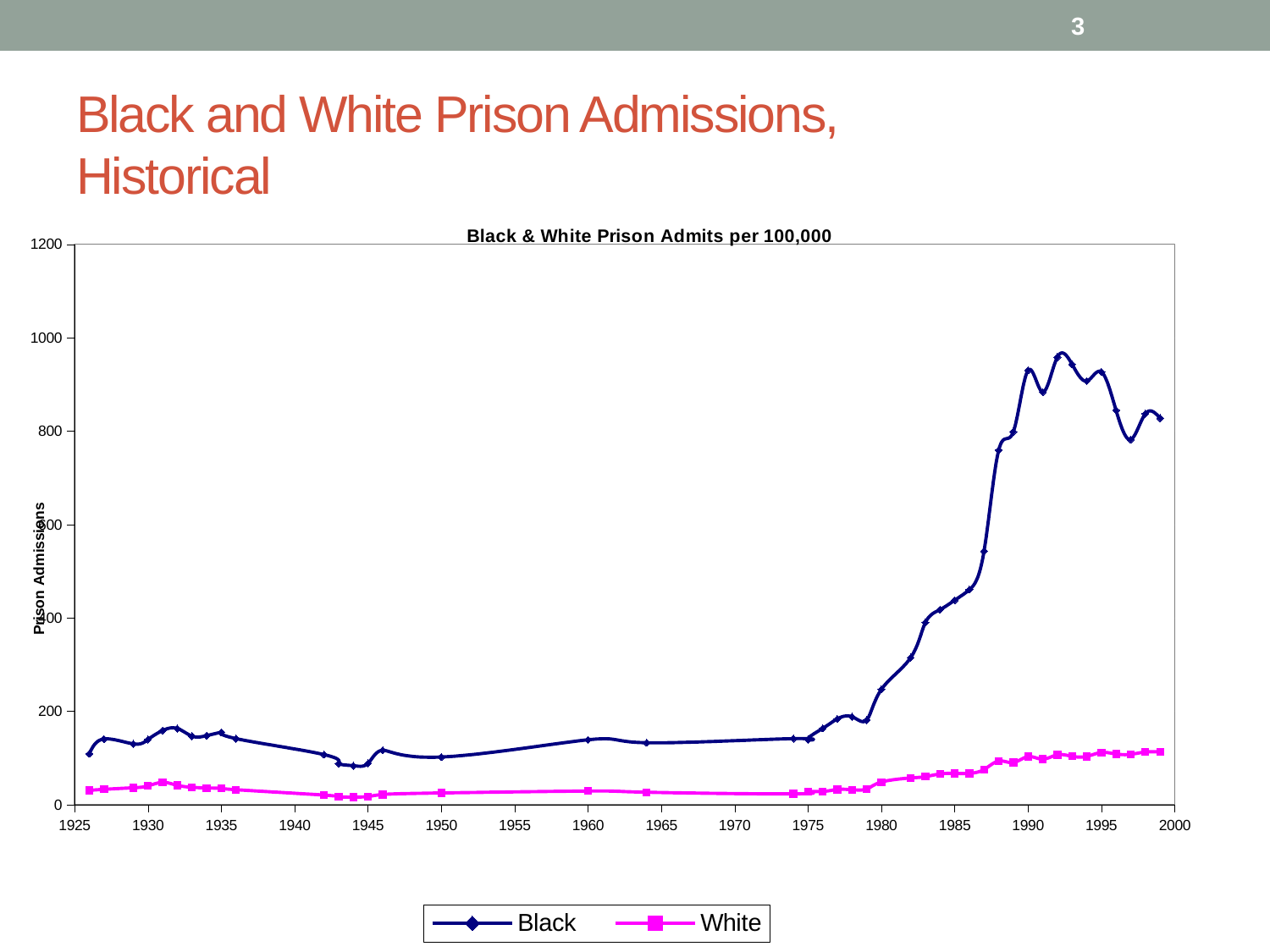
Is the value for White in 1995 greater or less than 200? less Is the value for Black in 1985 greater or less than 600? less Is the value for Black in 1988 greater or less than 600? greater What kind of chart is shown on the slide? Line chart Which series is drawn in magenta with square markers? White Does the Black series rise or fall between 1980 and 1990? Rise In 1990, which series has the higher value, Black or White? Black What is the title printed above the chart? Black & White Prison Admits per 100,000 How many series does the legend list? 2 Does the Black series rise or fall between 1992 and 1997? Fall